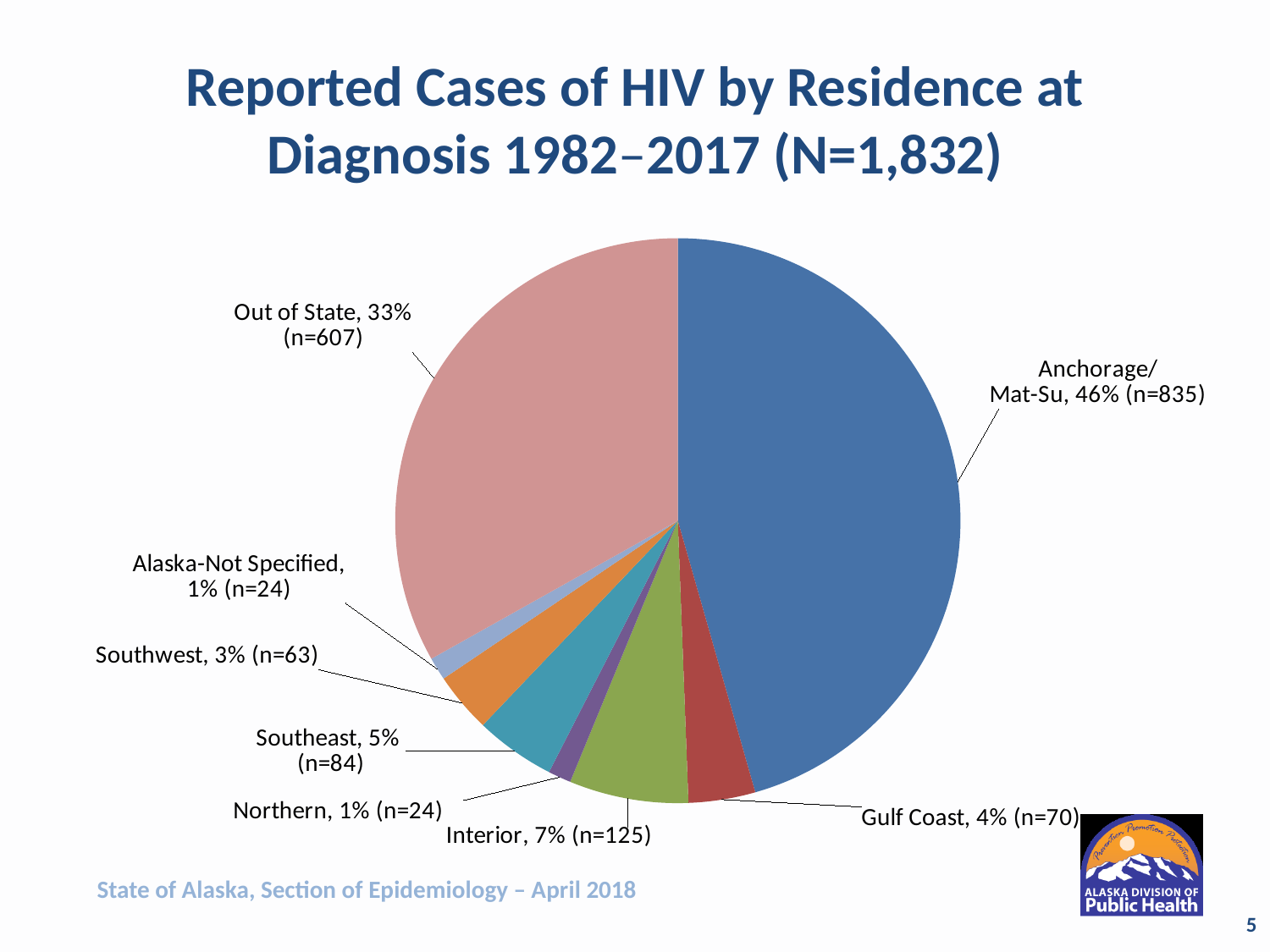
What is the total number of cases (N) stated in the chart title? 1,832 What share of the pie does the Interior slice represent? 7% How many residence categories are shown in the pie chart? 8 Which residence category has the largest share of reported HIV cases? Anchorage/Mat-Su How many cases (n) are shown for the Southeast region? 84 What is the difference in percentage points between the Interior and Southeast slices? 2 Which has more reported cases, Gulf Coast or Southwest? Gulf Coast What type of chart is shown on the slide? Pie chart What is the difference in number of cases between Anchorage/Mat-Su (n=835) and Out of State (n=607)? 228 What percentage of reported HIV cases had Anchorage/Mat-Su as residence at diagnosis? 46% How many reported HIV cases (n) were from Out of State? 607 Which two residence categories are tied for the smallest share at 1%? Northern and Alaska-Not Specified